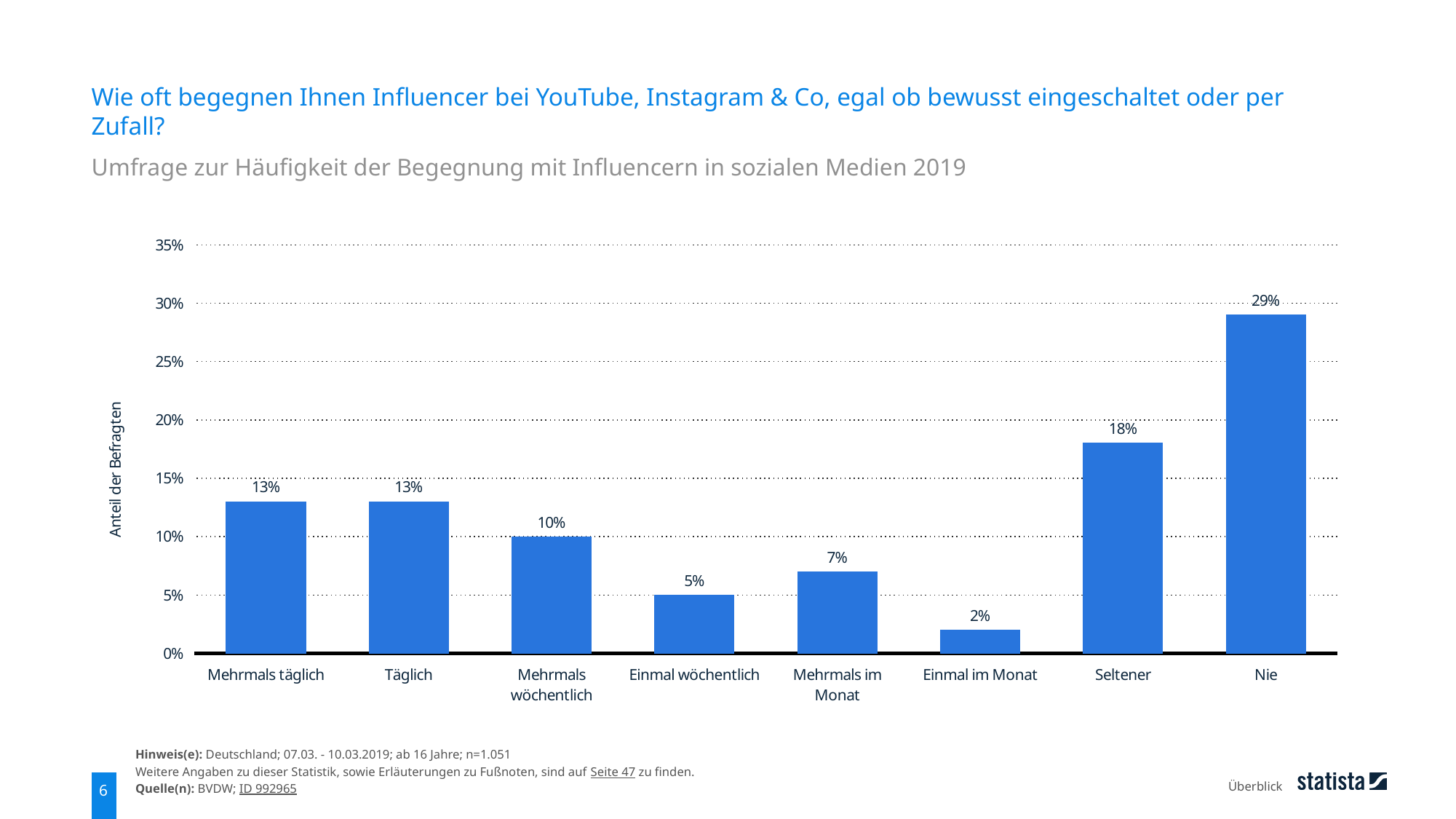
What is the value for "Mehrmals wöchentlich"? 10% Is the value for "Seltener" greater or less than 15%? greater Which is larger, the value for "Einmal wöchentlich" or the value for "Mehrmals im Monat"? Mehrmals im Monat What is the value for "Nie"? 29% What is the value for "Einmal im Monat"? 2% How many categories are shown on the x axis? 8 What kind of chart is shown on the slide? bar chart What is the label of the y axis? Anteil der Befragten What is the difference between the values for "Nie" and "Seltener"? 11% Which category has the lowest value? Einmal im Monat Which category has the highest value? Nie What is the value for "Seltener"? 18%